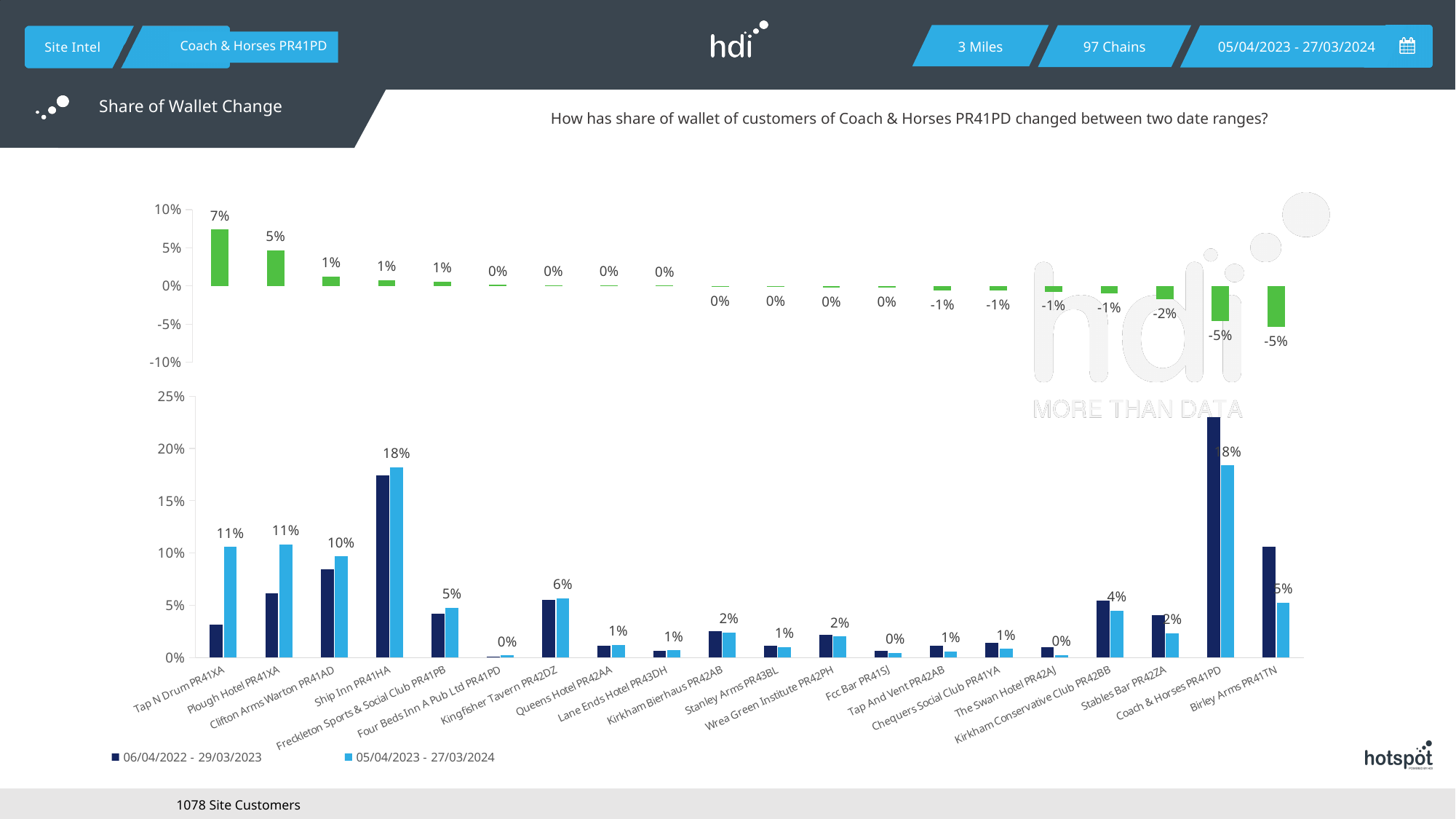
What type of chart is the top chart? bar chart In the bottom chart, what is the share of wallet for Kingfisher Tavern PR42DZ in the 05/04/2023 - 27/03/2024 period? 6% In the bottom chart, which is larger for Birley Arms PR41TN: the 06/04/2022 - 29/03/2023 bar or the 05/04/2023 - 27/03/2024 bar? 06/04/2022 - 29/03/2023 In the bottom chart, is the 06/04/2022 - 29/03/2023 value for Coach & Horses PR41PD greater or less than 20%? greater In the bottom chart, is the 06/04/2022 - 29/03/2023 value for Tap N Drum PR41XA greater or less than 5%? less In the bottom chart, what is the difference between the 05/04/2023 - 27/03/2024 values for Ship Inn PR41HA and Freckleton Sports & Social Club PR41PB? 13% In the top chart, what is the value of the first (leftmost) bar? 7% In the bottom chart, how many series does the legend list? 2 In the bottom chart, what is the share of wallet for Kirkham Conservative Club PR42BB in the 05/04/2023 - 27/03/2024 period? 4% In the bottom chart, how many venues are shown on the x axis? 20 In the bottom chart, what is the share of wallet for Ship Inn PR41HA in the 05/04/2023 - 27/03/2024 period? 18% In the top chart, what is the highest value shown? 7%